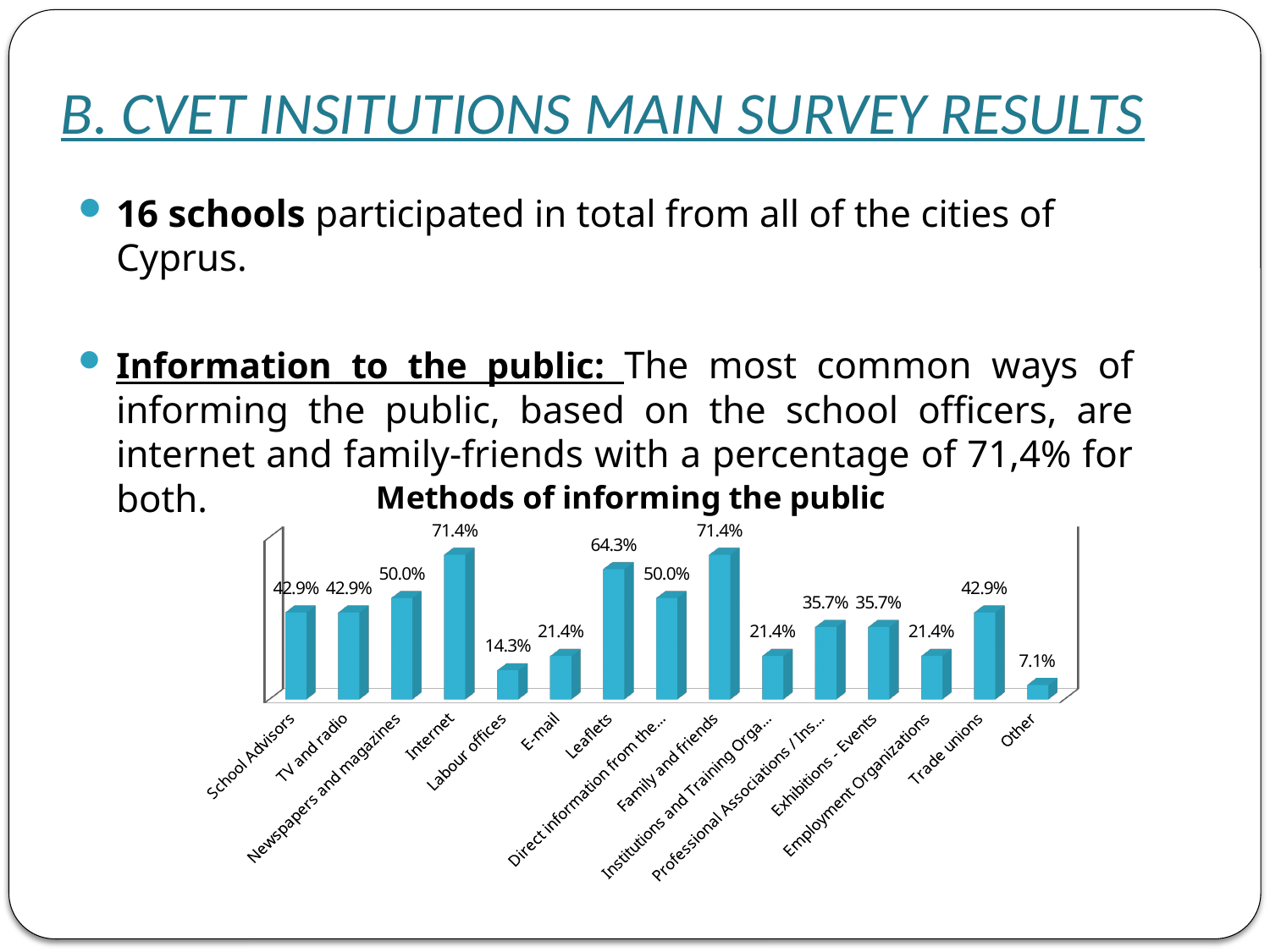
What is the difference between the values for Internet and Newspapers and magazines? 21.4 percentage points How many categories are shown in the chart? 15 What is the difference between the values for Leaflets and Labour offices? 50.0 percentage points Which category has the lowest value in the chart? Other What is the value for Labour offices? 14.3% What is the title of the chart? Methods of informing the public What is the value for Trade unions? 42.9% What percentage is shown for Leaflets? 64.3% What kind of chart is shown on the slide? Bar chart What percentage is shown for Internet in the Methods of informing the public chart? 71.4% What percentage is shown for Exhibitions - Events? 35.7% Which is larger, the value for Leaflets or the value for Newspapers and magazines? Leaflets